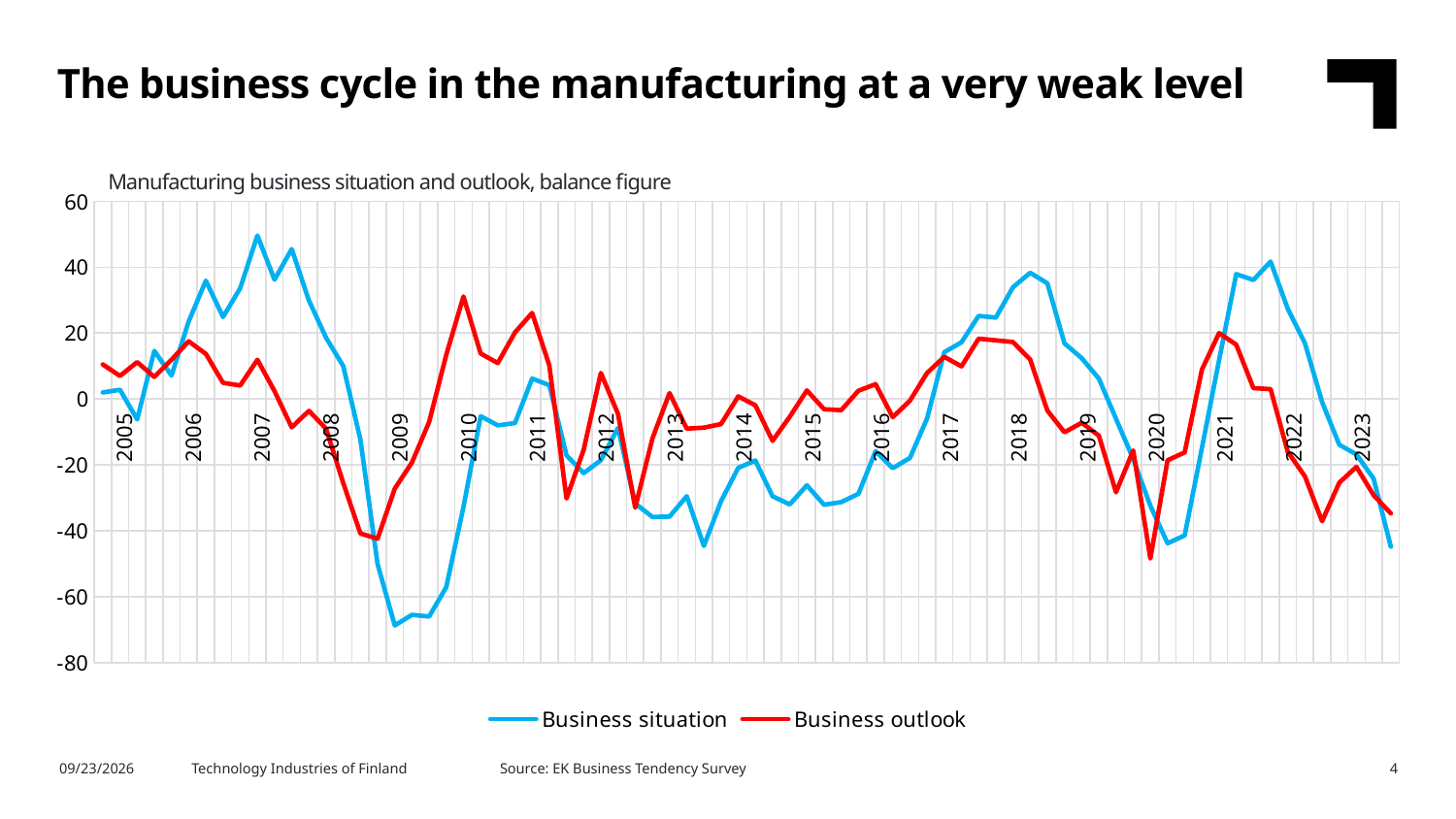
Is the peak of the Business outlook line in 2010 greater or less than 20? greater At the end of 2023, which line is higher, Business situation or Business outlook? Business outlook How many series does the legend list? 2 Does the Business situation line rise or fall from its 2022 peak to the end of 2023? fall In which year does the Business situation line reach its highest value? 2007 What are the two series named in the legend? Business situation and Business outlook What is the chart's title? Manufacturing business situation and outlook, balance figure How many years are labelled on the x axis? 19 Is the lowest value of the Business situation line, reached in 2009, greater or less than -60? less Is the peak of the Business situation line in 2007 greater or less than 40? greater What kind of chart is shown on the slide? line chart